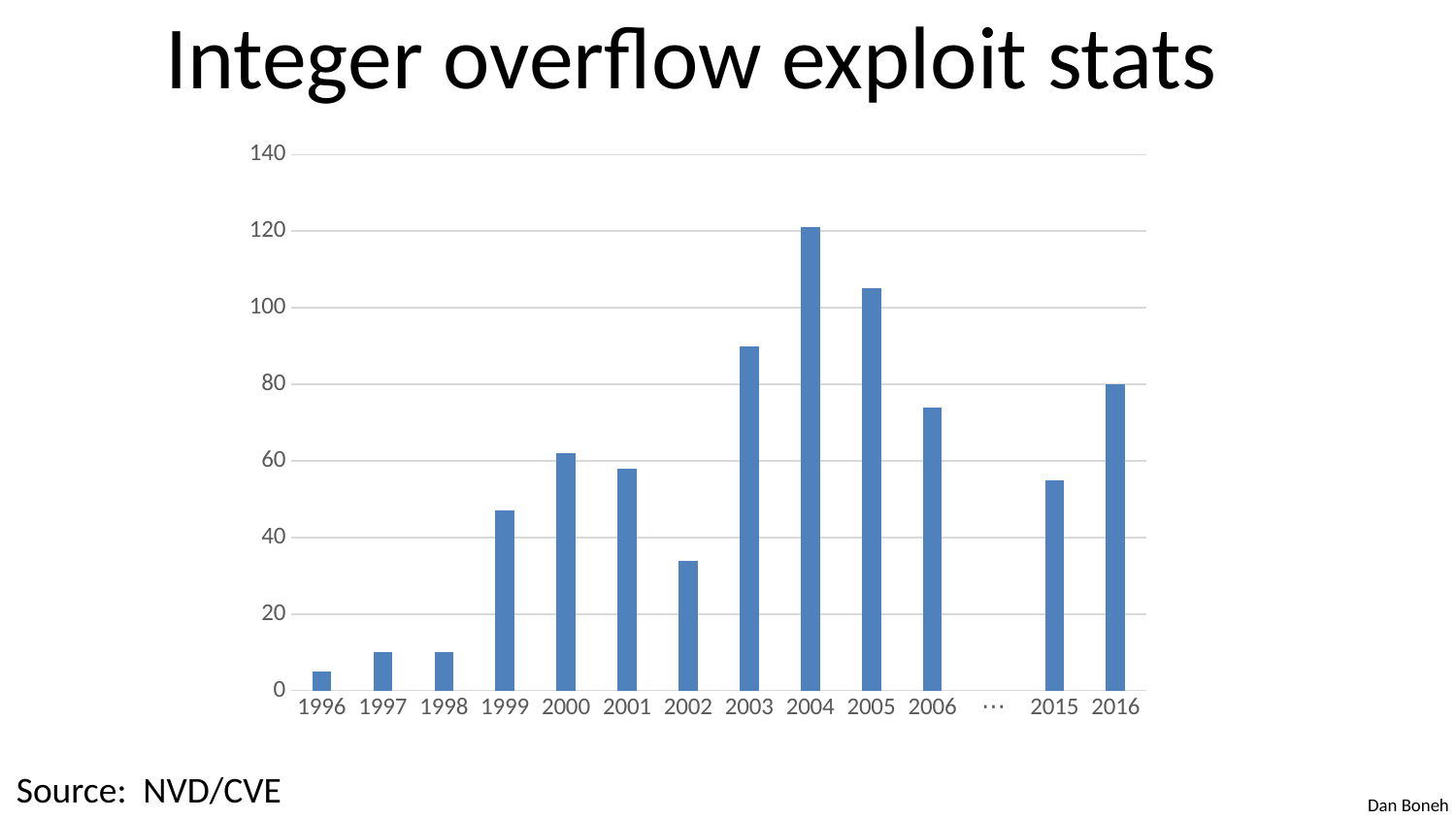
Do the values rise or fall from 1996 to 2004? rise Which year has the lowest bar? 1996 What type of chart is shown on the slide? bar chart Which is larger, the value for 2003 or the value for 2005? 2005 Is the value for 2002 greater or less than 40? less Is the value for 2003 greater or less than 100? less Which is larger, the value for 2002 or the value for 2015? 2015 Is the value for 2004 greater or less than 100? greater How many bars are plotted in the chart? 13 Which year has the highest bar? 2004 What is the title of the chart? Integer overflow exploit stats